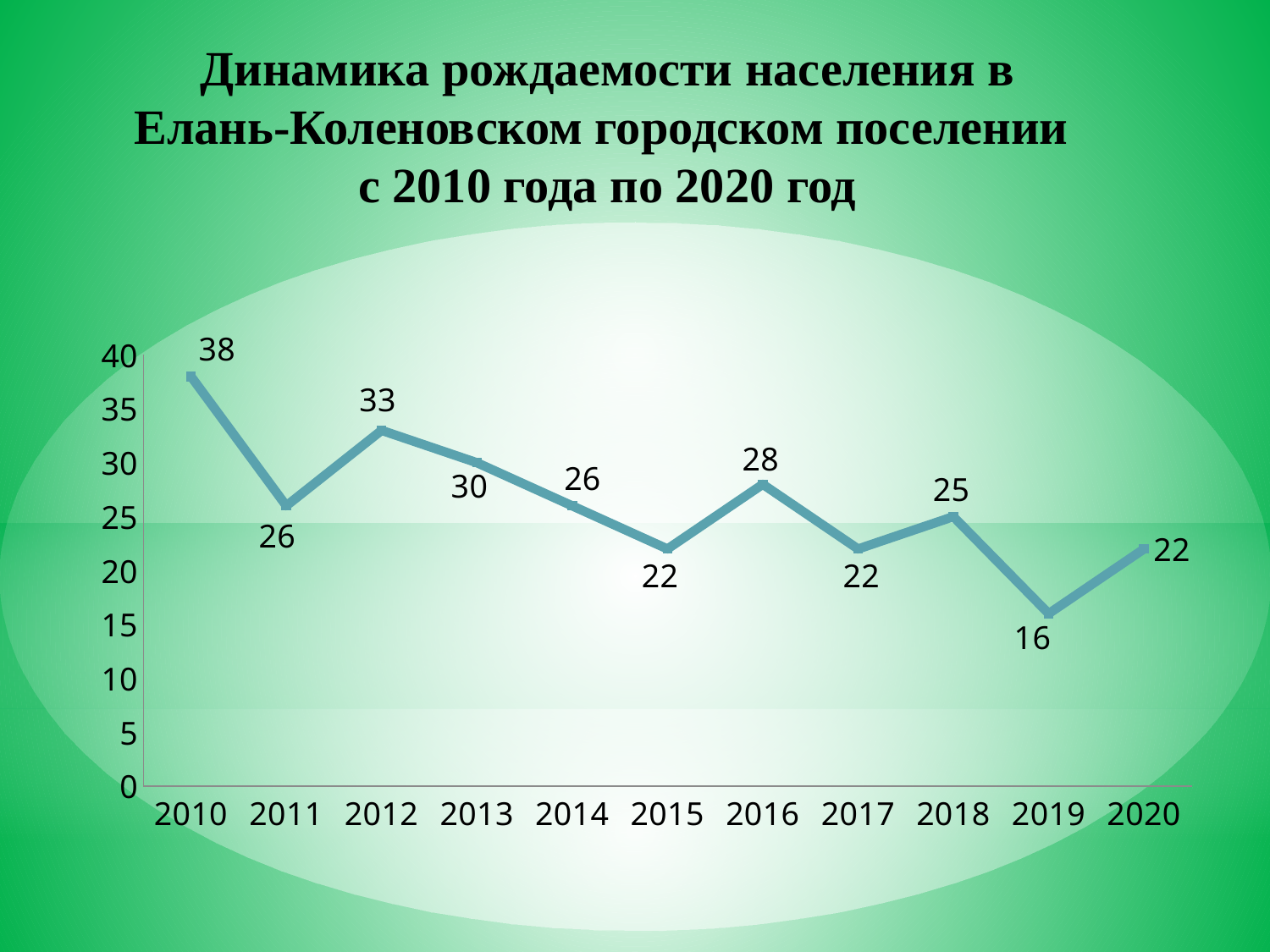
How many years are plotted on the chart? 11 What kind of chart is shown on the slide? line chart Which year has the highest value? 2010 Is the value for 2014 greater or less than 25? greater What is the value for 2016? 28 Which year has the lowest value? 2019 What is the value for 2010? 38 What is the difference between the values for 2010 and 2011? 12 Which is larger, the value for 2012 or the value for 2013? 2012 What is the difference between the values for 2018 and 2019? 9 What is the value for 2019? 16 Do the values generally rise or fall from 2010 to 2020? fall